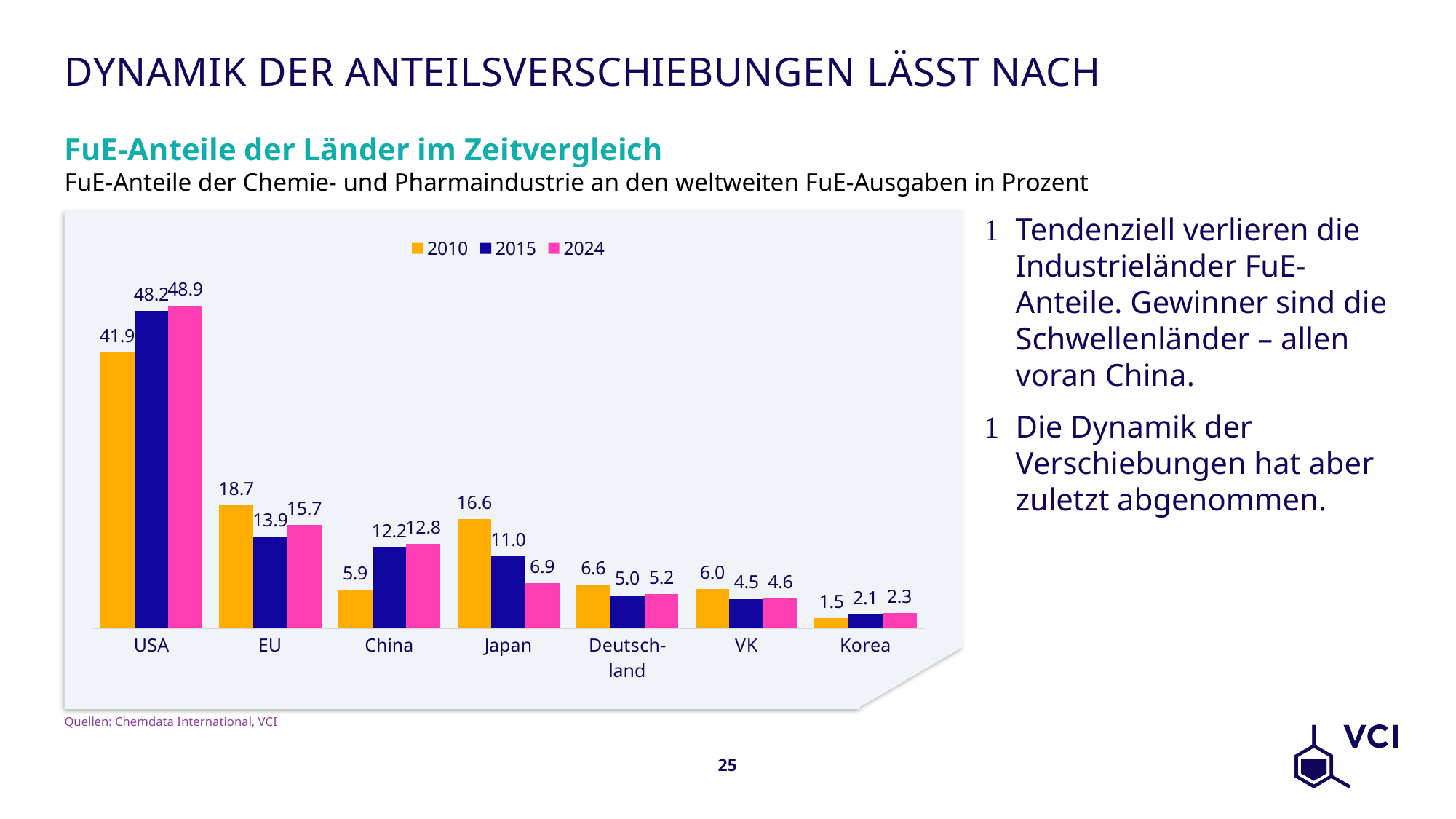
Which country has the highest value in 2024? USA What is the title of the chart? FuE-Anteile der Länder im Zeitvergleich What is the difference between the EU's 2010 value and its 2024 value? 3.0 Which is larger: China's 2024 value or Japan's 2024 value? China's 2024 value Which country has the lowest value in 2010? Korea What kind of chart is shown? Bar chart How many series does the legend list? 3 What is the value for China in 2010? 5.9 Do Japan's values rise or fall from 2010 to 2024? Fall How many countries or regions are shown on the x axis? 7 What is the value for Japan in 2015? 11.0 What is the value for the USA in 2024? 48.9